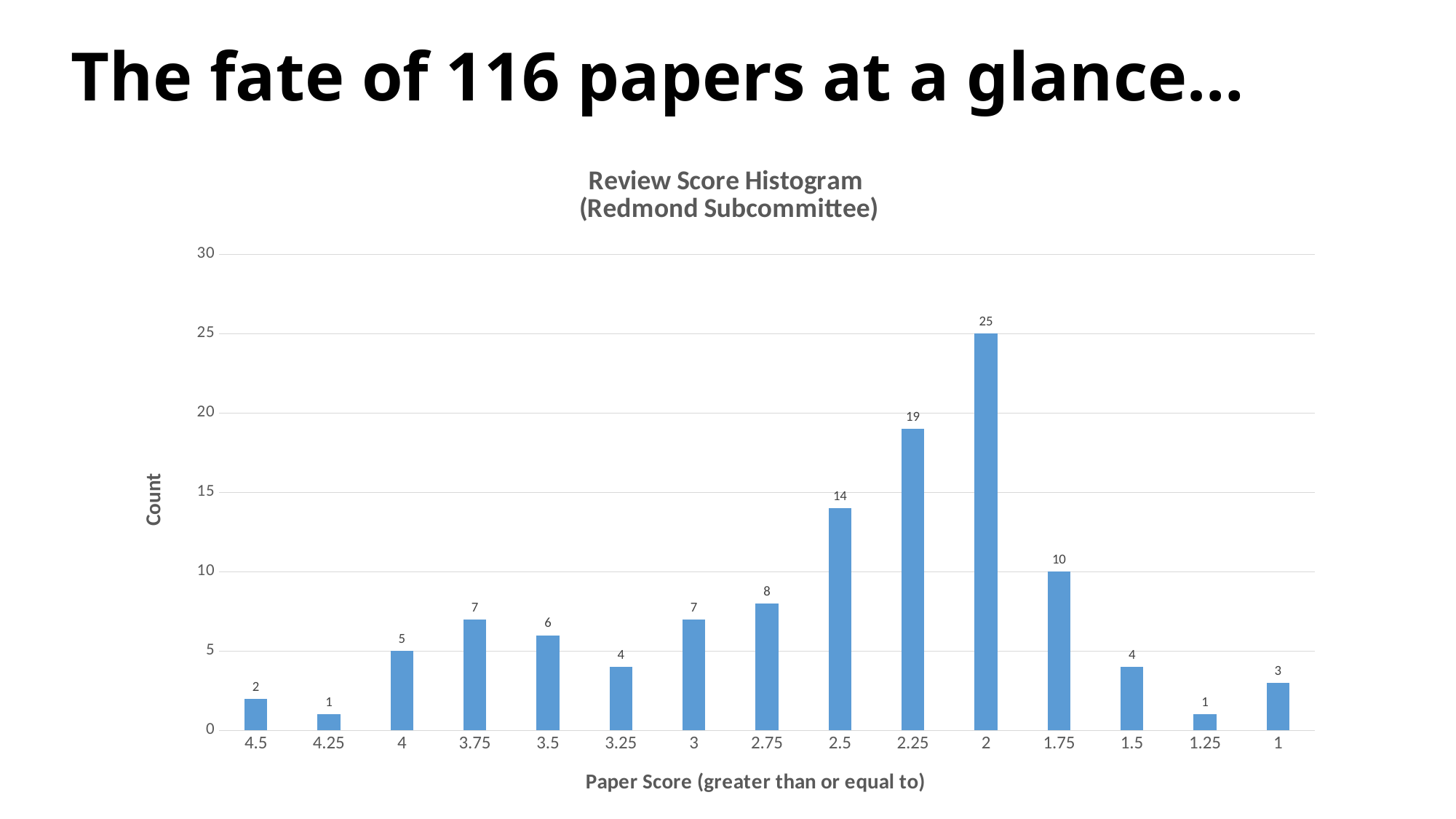
Which has a larger count, paper score 1.75 or paper score 2.75? 1.75 Which paper scores have the lowest count? 4.25 and 1.25 What kind of chart is shown on the slide? bar chart What is the count for a paper score of 2.5? 14 How many paper score categories are shown on the x axis? 15 What is the title of the chart? Review Score Histogram (Redmond Subcommittee) Is the count for paper score 2.25 greater or less than 15? greater What is the difference between the counts for paper scores 2 and 2.25? 6 What is the count for a paper score of 3.75? 7 What is the label of the y axis? Count What is the count for a paper score of 2? 25 Which paper score has the highest count? 2